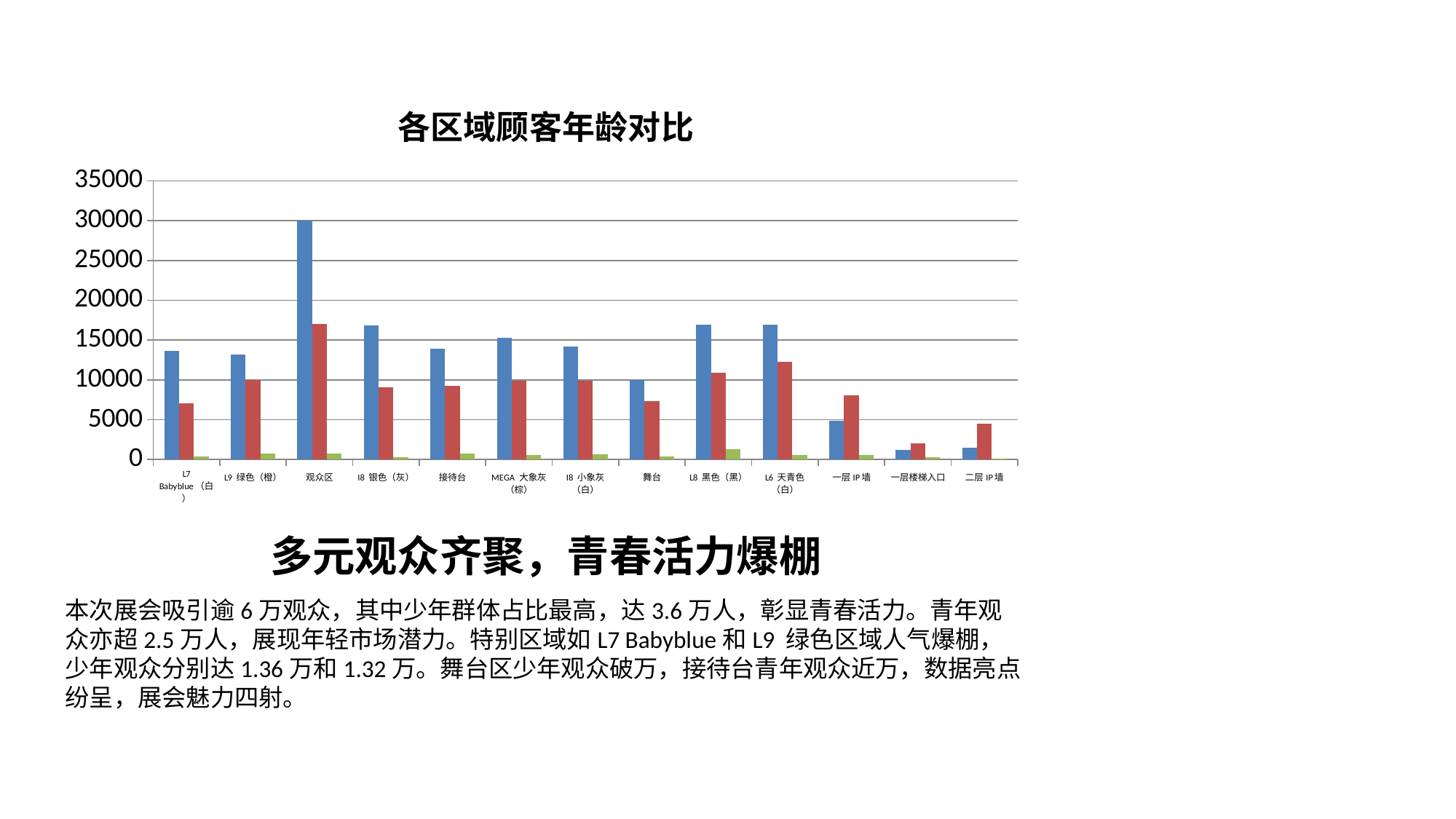
Is the red bar for 观众区 greater or less than 15000? greater For L7 Babyblue（白）, which is larger, the blue bar or the red bar? the blue bar How many categories are shown on the x axis of the chart? 13 Which category has the tallest blue bar? 观众区 Is the blue bar for 一层 IP 墙 greater or less than 10000? less How many differently coloured bars are plotted for each category? 3 Which category has the shortest blue bar? 一层楼梯入口 For 一层 IP 墙, which is larger, the blue bar or the red bar? the red bar What is the title of the chart? 各区域顾客年龄对比 What kind of chart is shown on the slide? bar chart Is the blue bar for 舞台 greater or less than 15000? less